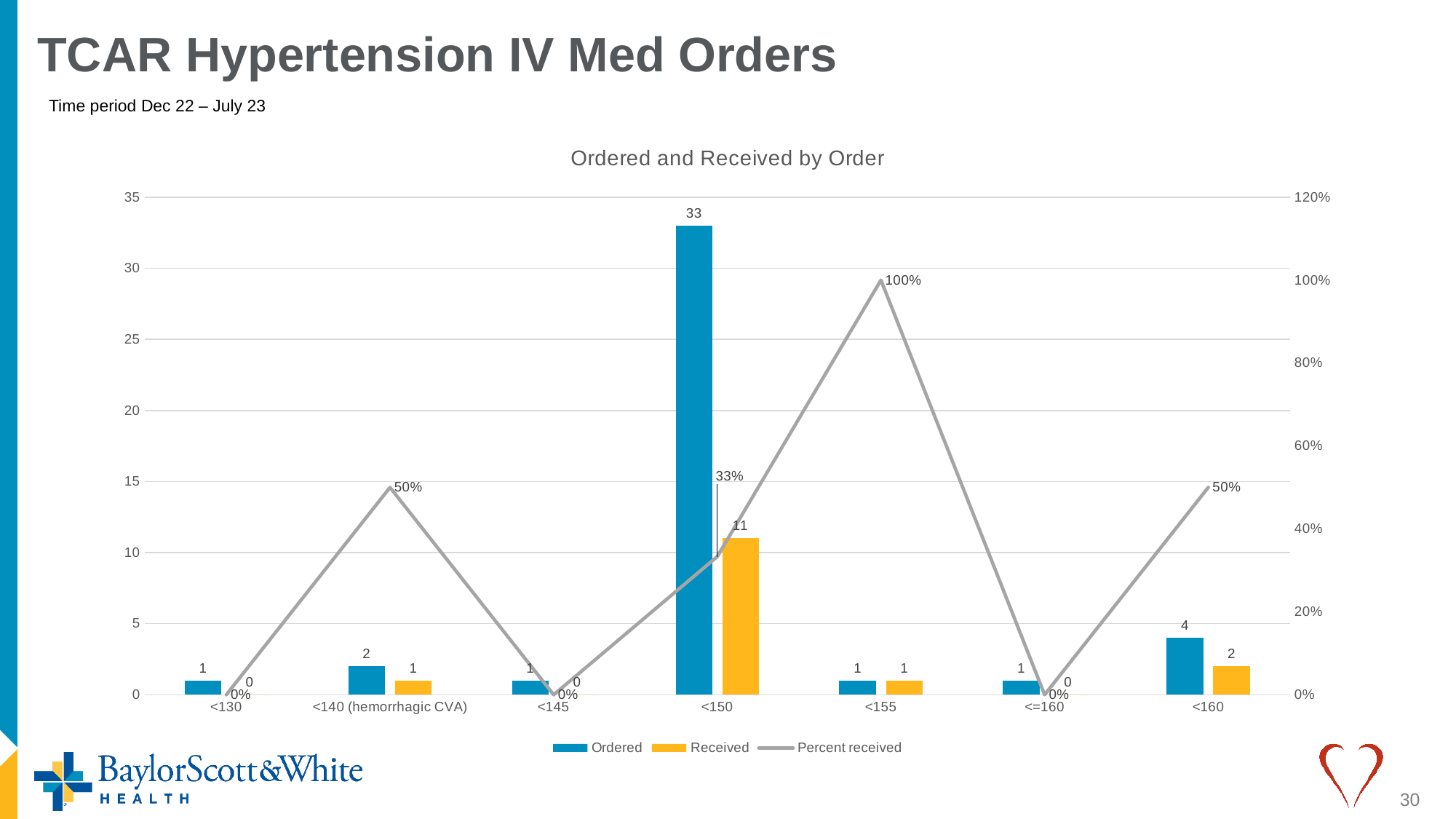
What is the Ordered value for the <160 category? 4 How many categories are shown on the x axis? 7 What is the Received value for the <150 category? 11 Which category has the highest Percent received? <155 What is the Percent received for the <155 category? 100% What is the Ordered value for the <150 category? 33 How many series does the legend list? 3 What is the Percent received for the <140 (hemorrhagic CVA) category? 50% Which category has the highest Ordered value? <150 What is the difference between Ordered and Received for the <150 category? 22 Which is larger for the <160 category, Ordered or Received? Ordered What is the title of the chart? Ordered and Received by Order